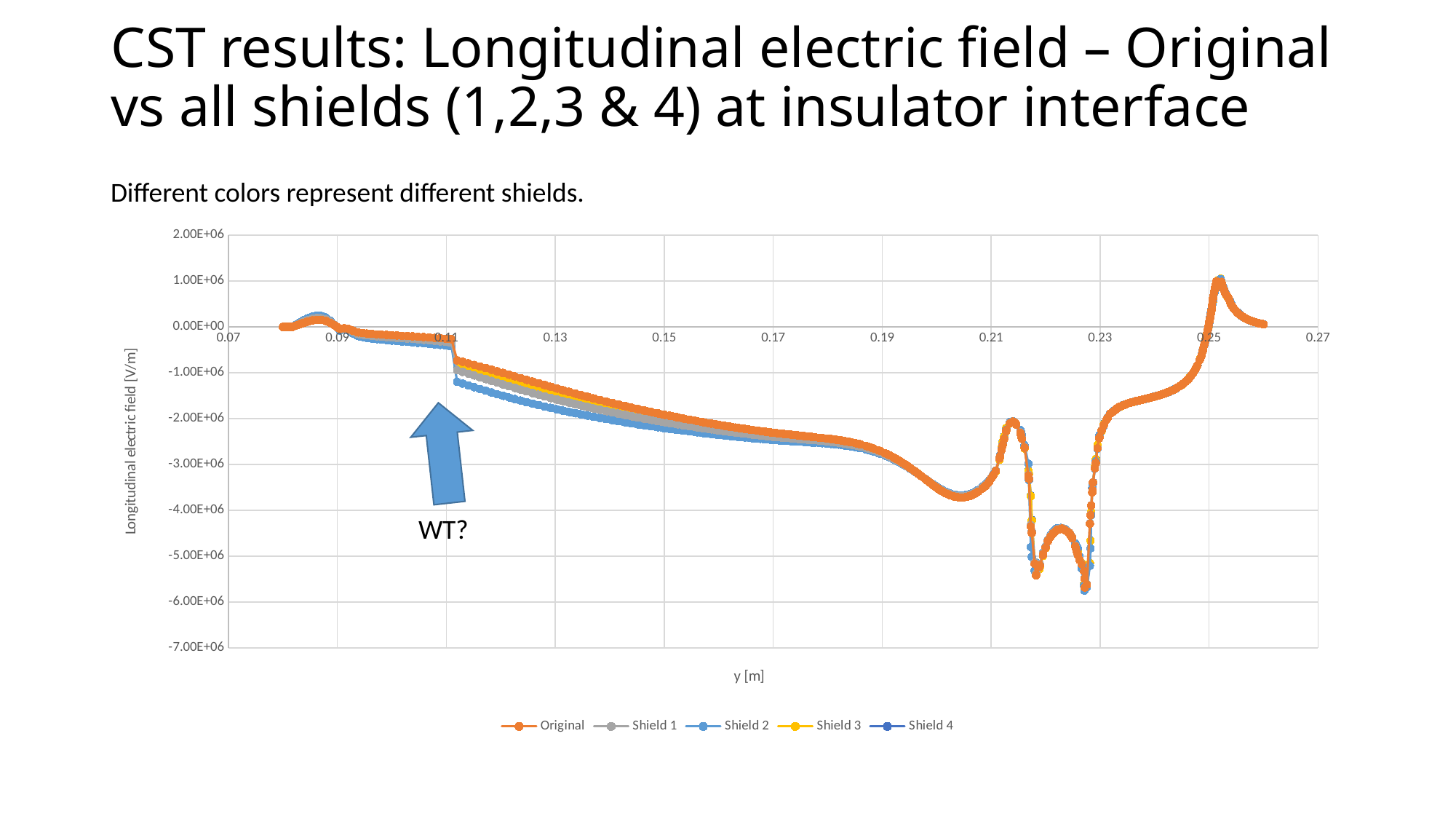
How many series does the chart legend list? 5 Do the curves rise or fall as y increases from 0.11 to 0.19? fall Is the value of the curves at y = 0.19 greater or less than -3.00E+06? greater Is the local minimum of the curves near y = 0.205 greater or less than -3.00E+06? less Do the curves rise or fall as y increases from 0.23 to 0.25? rise What is the label of the x axis of the chart? y [m] What is the lowest tick value shown on the y axis of the chart? -7.00E+06 What are the names of the series listed in the chart legend? Original, Shield 1, Shield 2, Shield 3, Shield 4 What kind of chart is shown on the slide? line chart